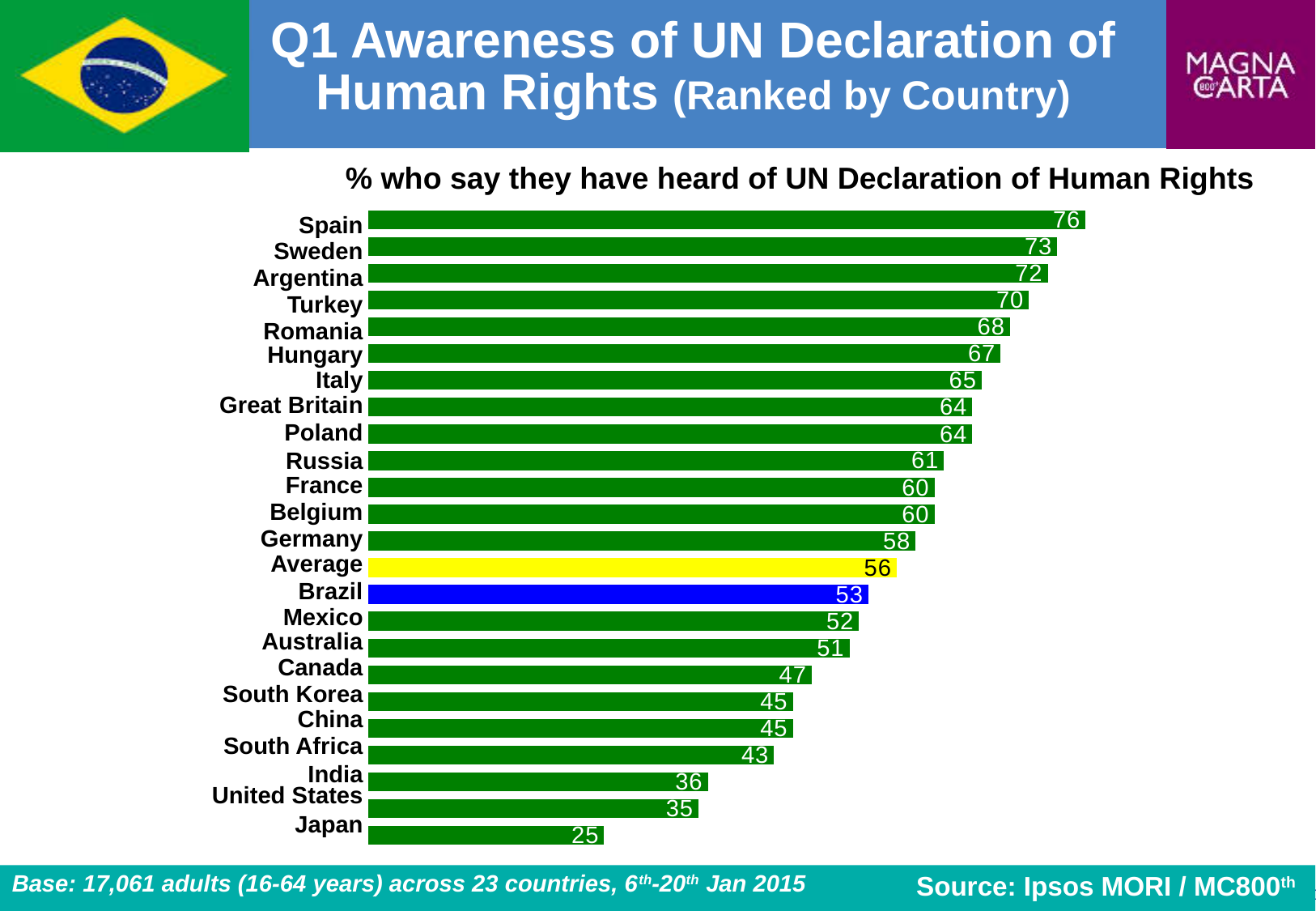
Which country has the lowest value? Japan What is the value for United States? 35 Which has a larger value, Germany or Mexico? Germany What is the value for the Average bar? 56 What is the value for Spain? 76 What is the value for Brazil? 53 What is the difference between the values for Spain and Japan? 51 What colour is the bar for Brazil? Blue What kind of chart is this? Bar chart What is the difference between the values for Brazil and the Average? 3 Which country has the highest value? Spain How many bars are shown in the chart? 24